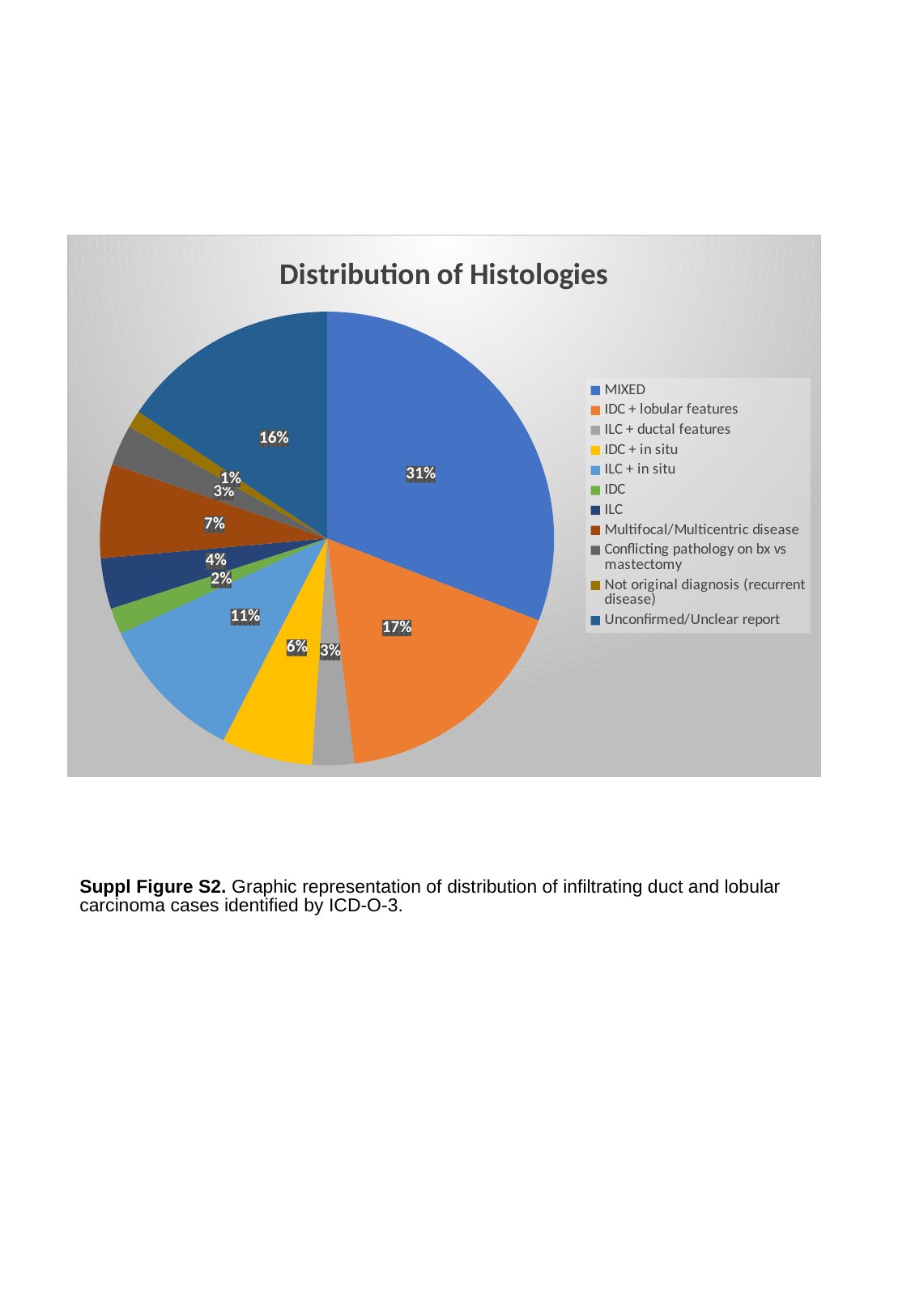
What share of the pie does ILC + in situ represent? 11% What share of the pie does IDC + in situ represent? 6% What is the title of the pie chart? Distribution of Histologies Which category has the smallest slice of the pie? Not original diagnosis (recurrent disease) What type of chart is shown on the slide? pie chart Which is larger, the share for Multifocal/Multicentric disease or the share for ILC? Multifocal/Multicentric disease How many categories does the legend of the pie chart list? 11 Which category has the largest slice of the pie? MIXED What share of the pie does IDC + lobular features represent? 17% What is the difference in percentage points between MIXED and IDC + lobular features? 14